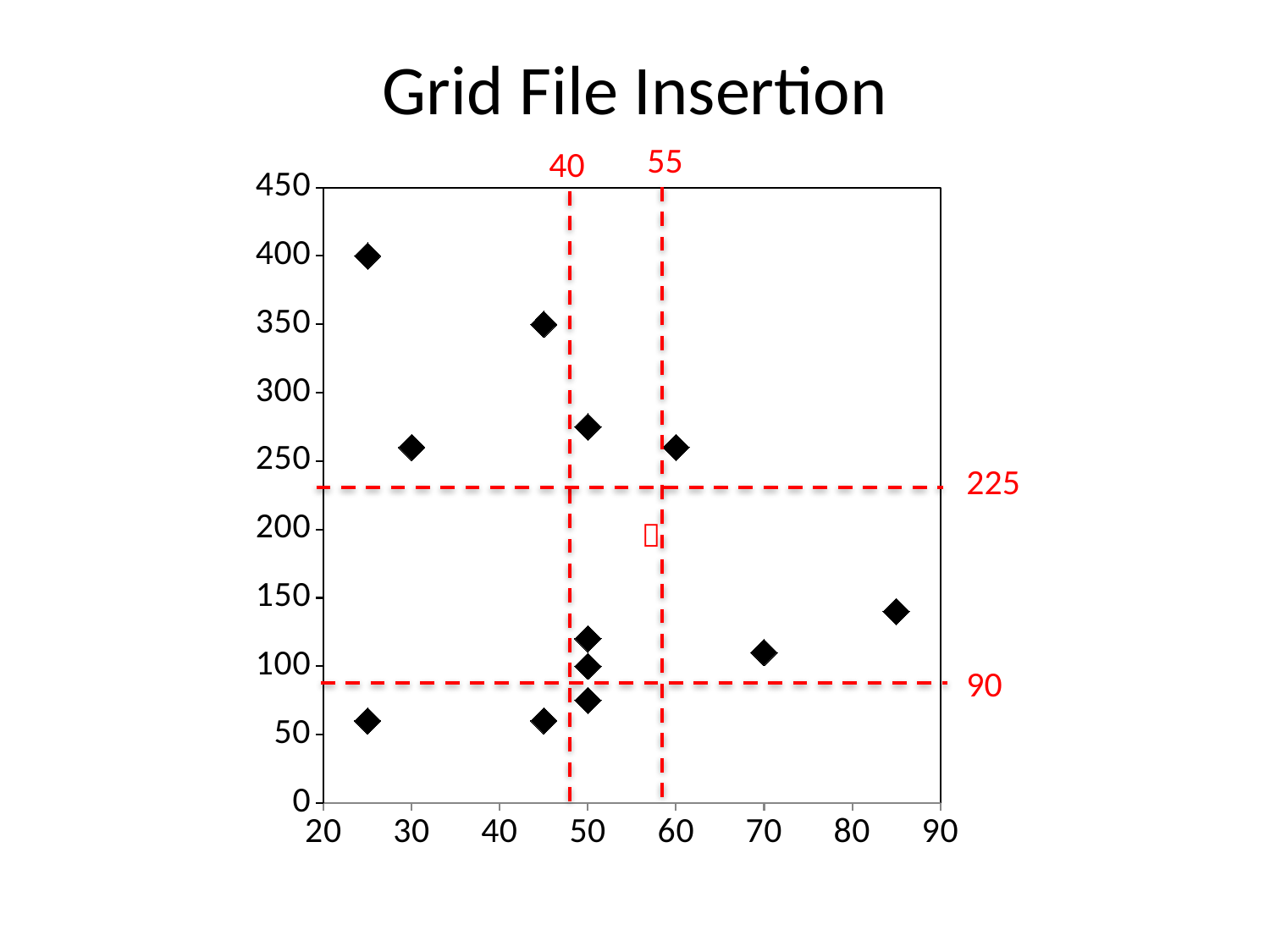
What is the maximum value shown on the y-axis? 450 What is the title of the chart? Grid File Insertion What kind of chart is shown on the slide? scatter chart Which has the higher y-value: the point at x = 70 or the point at x = 85? the point at x = 85 What are the labels on the two vertical red dashed lines? 40 and 55 How many black diamond data points are plotted on the chart? 12 Which has the higher y-value: the point at x = 45 near the top of the chart or the point at x = 30 near the middle? the point at x = 45 What is the y-value of the highest plotted point on the chart? 400 Is the y-value of the point at x = 70 greater or less than 150? less Is the y-value of the point at x = 85 greater or less than 100? greater Is the y-value of the point at x = 30 greater or less than 200? greater